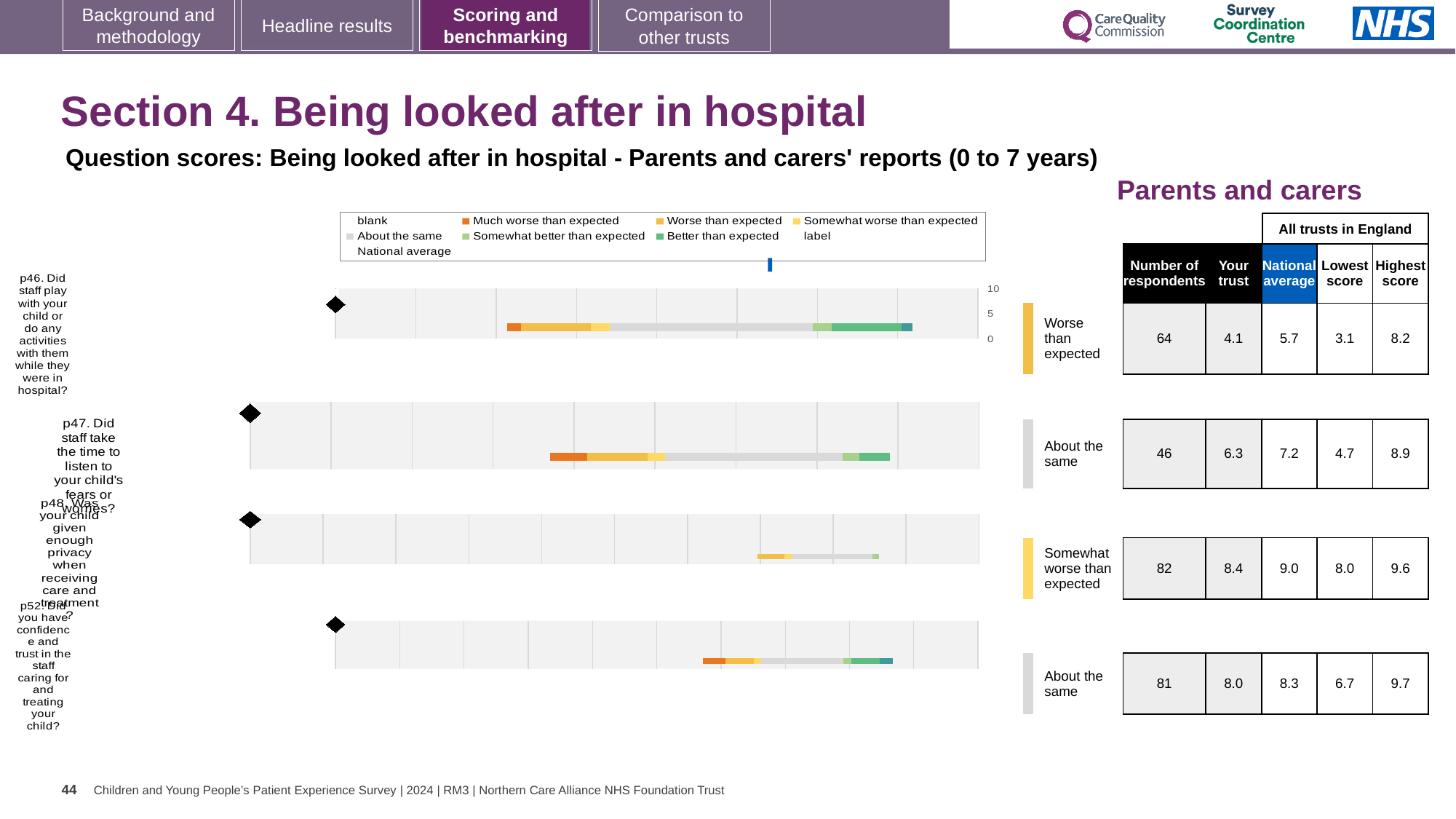
What kind of chart is used for each question on the slide? Bar chart How many question charts are shown on the slide? 4 Which question has the highest 'Your trust' score? p48 Which has the larger 'Your trust' score, p47 or p52? p52 How many respondents answered p47 (Did staff take the time to listen to your child's fears or worries?)? 46 For p46, what is the difference between the national average and the 'Your trust' score? 1.6 What is the maximum value shown on the score axis of the p46 chart? 10 What is the national average score for p48 (Was your child given enough privacy when receiving care and treatment?)? 9.0 Which question has the lowest 'Your trust' score? p46 What benchmark category is shown for p46? Worse than expected What is the highest score across all trusts in England for p52 (Did you have confidence and trust in the staff caring for and treating your child?)? 9.7 What is the 'Your trust' score for p46 (Did staff play with your child or do any activities with them while they were in hospital?)? 4.1